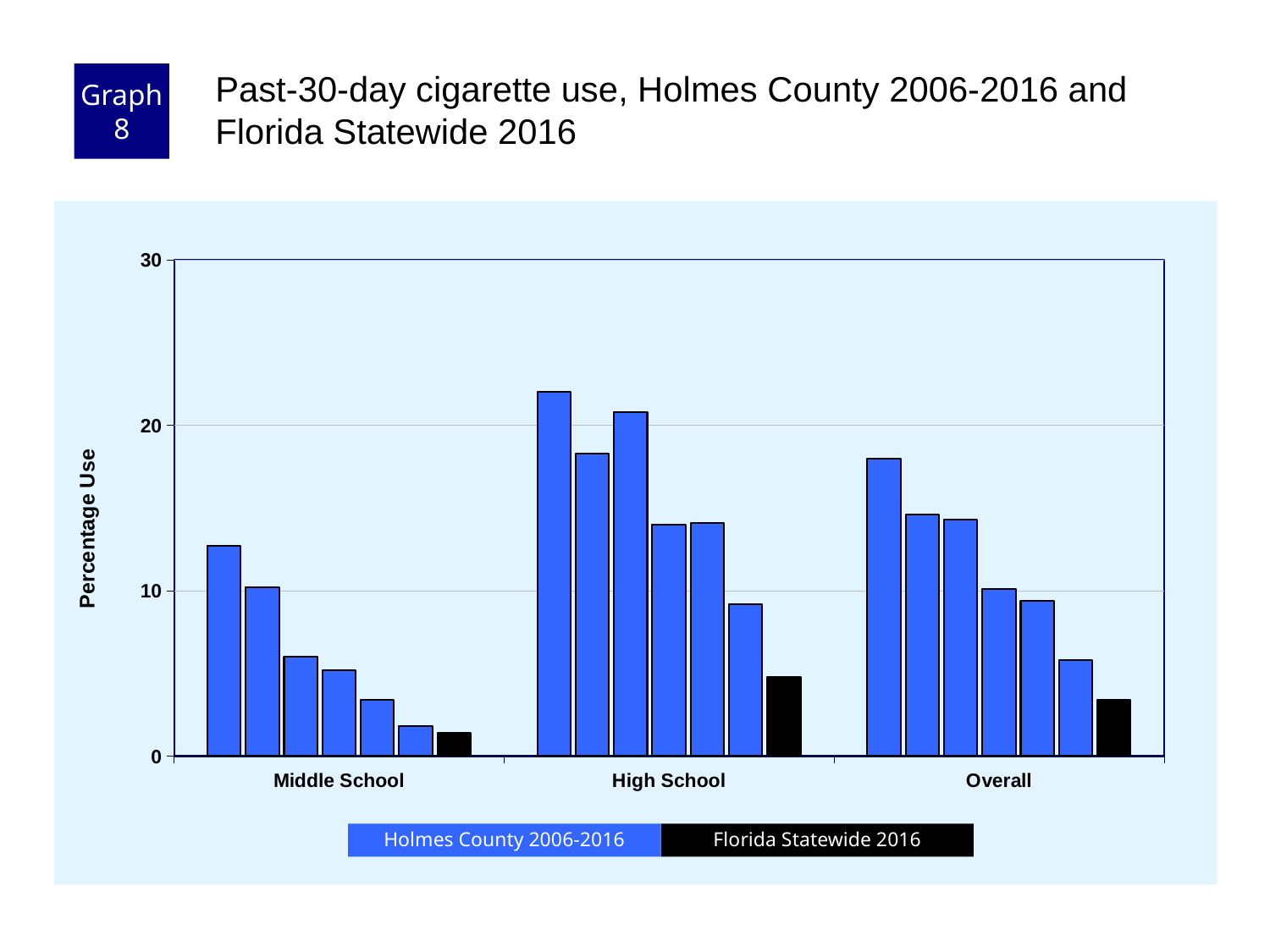
Which is larger, the Florida Statewide 2016 value for High School or for Middle School? High School Is the tallest Holmes County 2006-2016 bar in the High School group greater or less than 20? greater What kind of chart is shown on the slide? Bar chart How many series does the legend list? 2 Which category group contains the tallest bar in the chart? High School Is the Florida Statewide 2016 value for High School greater or less than 10? less Is the Florida Statewide 2016 value for Middle School greater or less than 5? less What colour are the Florida Statewide 2016 bars? Black How many category groups are shown on the x axis? 3 Within the Middle School group, do the Holmes County 2006-2016 bars generally rise or fall from left to right? fall What is the title of the y axis? Percentage Use